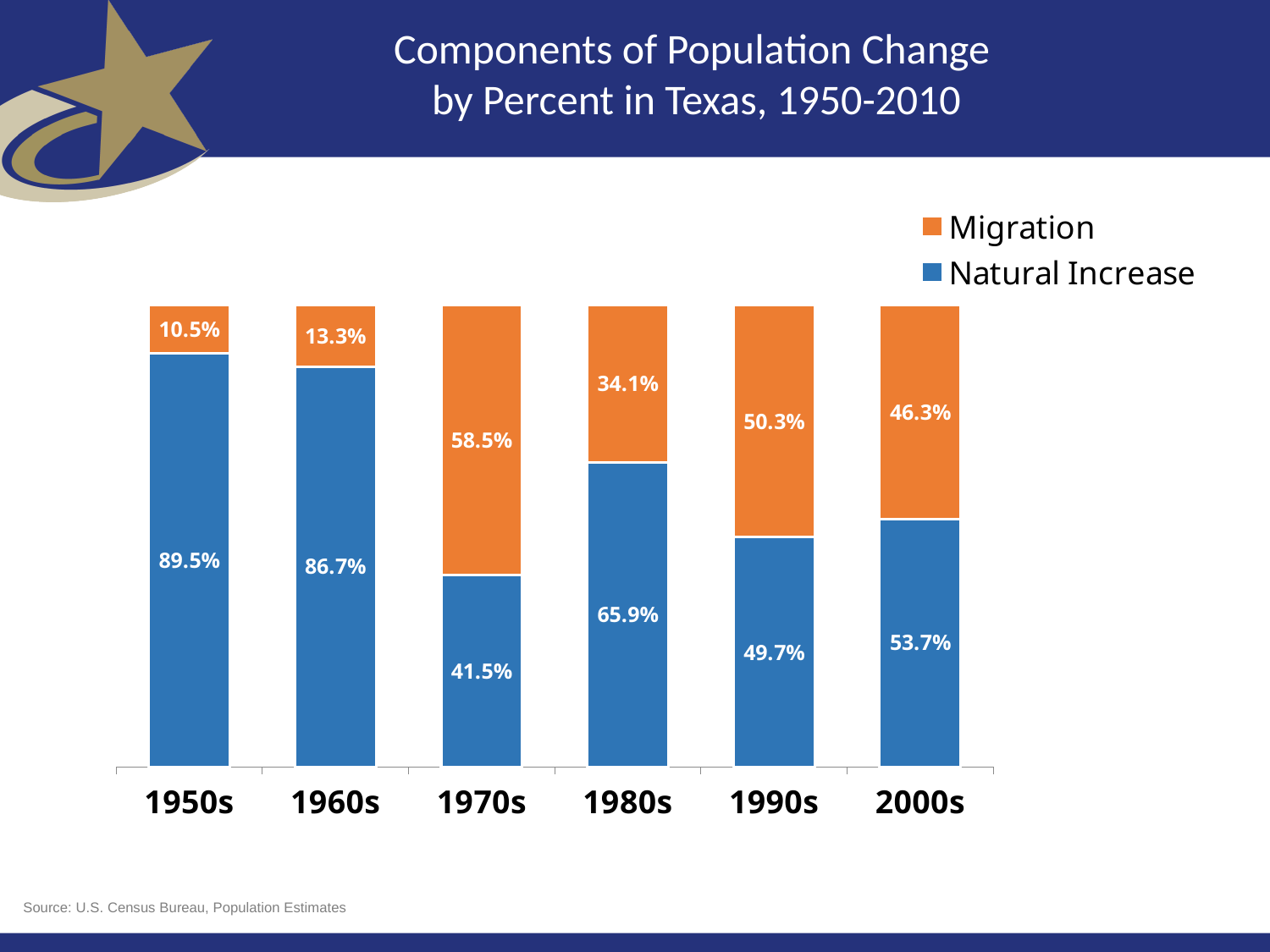
How many decades are shown on the x axis? 6 What is the difference between the Natural Increase values for the 1950s and the 1960s? 2.8% What is the Migration value for the 1970s? 58.5% In which decade is the Natural Increase share lowest? 1970s Which is larger in the 1990s, Migration or Natural Increase? Migration How many series does the legend list? 2 What is the Natural Increase value for the 1950s? 89.5% What is the Migration value for the 1980s? 34.1% In which decade is the Migration share highest? 1970s What kind of chart is shown on the slide? Stacked bar chart Which colour represents Migration in the chart? Orange What is the Natural Increase value for the 2000s? 53.7%